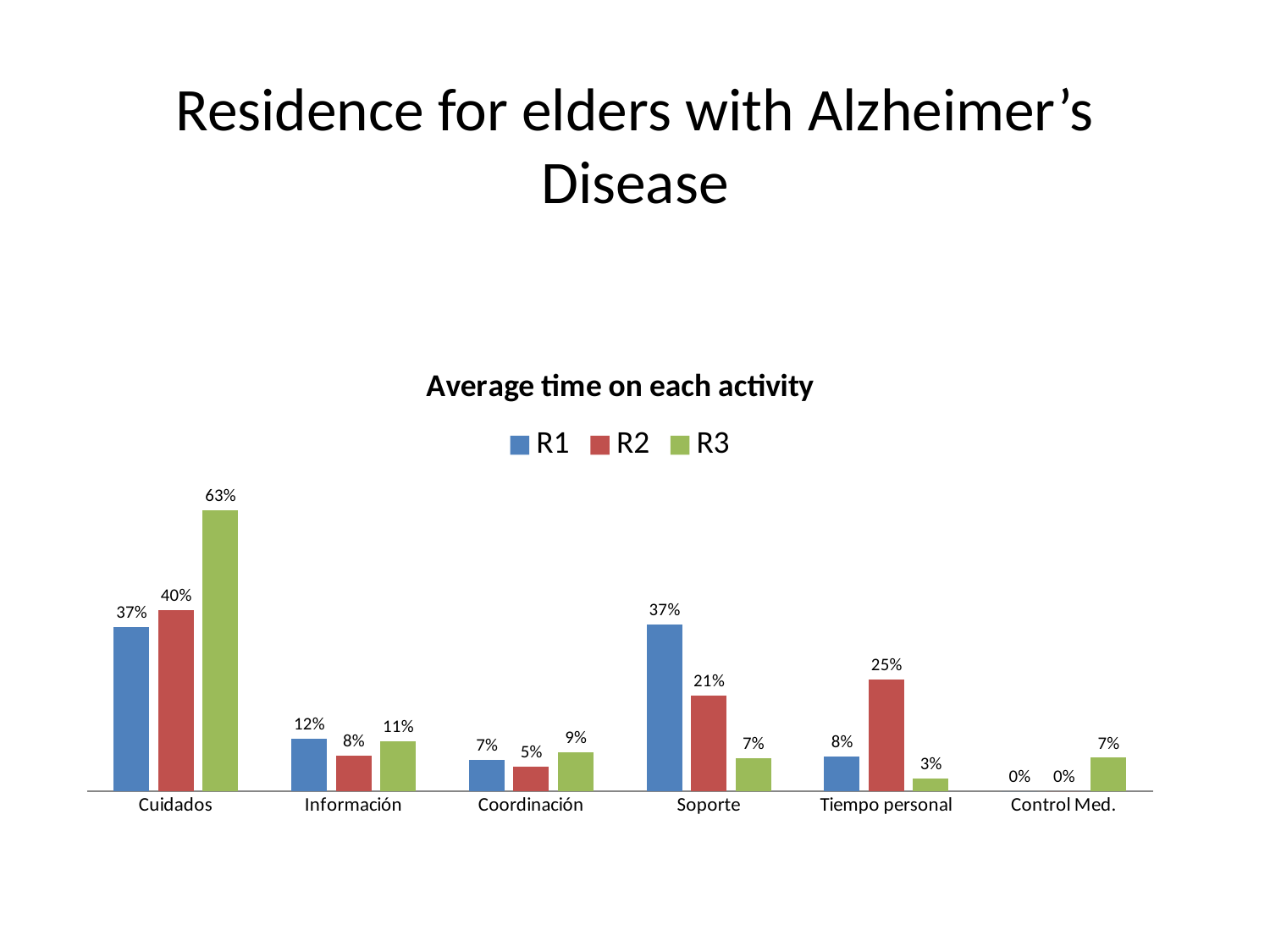
What kind of chart is shown on the slide? Bar chart Which category has the highest value for R3? Cuidados How many categories are shown on the x axis? 6 What is the value for R3 in the Cuidados category? 63% What is the title of the chart? Average time on each activity Which category has the lowest value for R2? Control Med. How many series does the legend list? 3 What colour are the R2 bars? Red Which is larger in the Soporte category, the R1 value or the R2 value? R1 What is the value for R2 in the Tiempo personal category? 25% What is the value for R1 in the Soporte category? 37% What is the difference between the R3 and R1 values in the Cuidados category? 26%